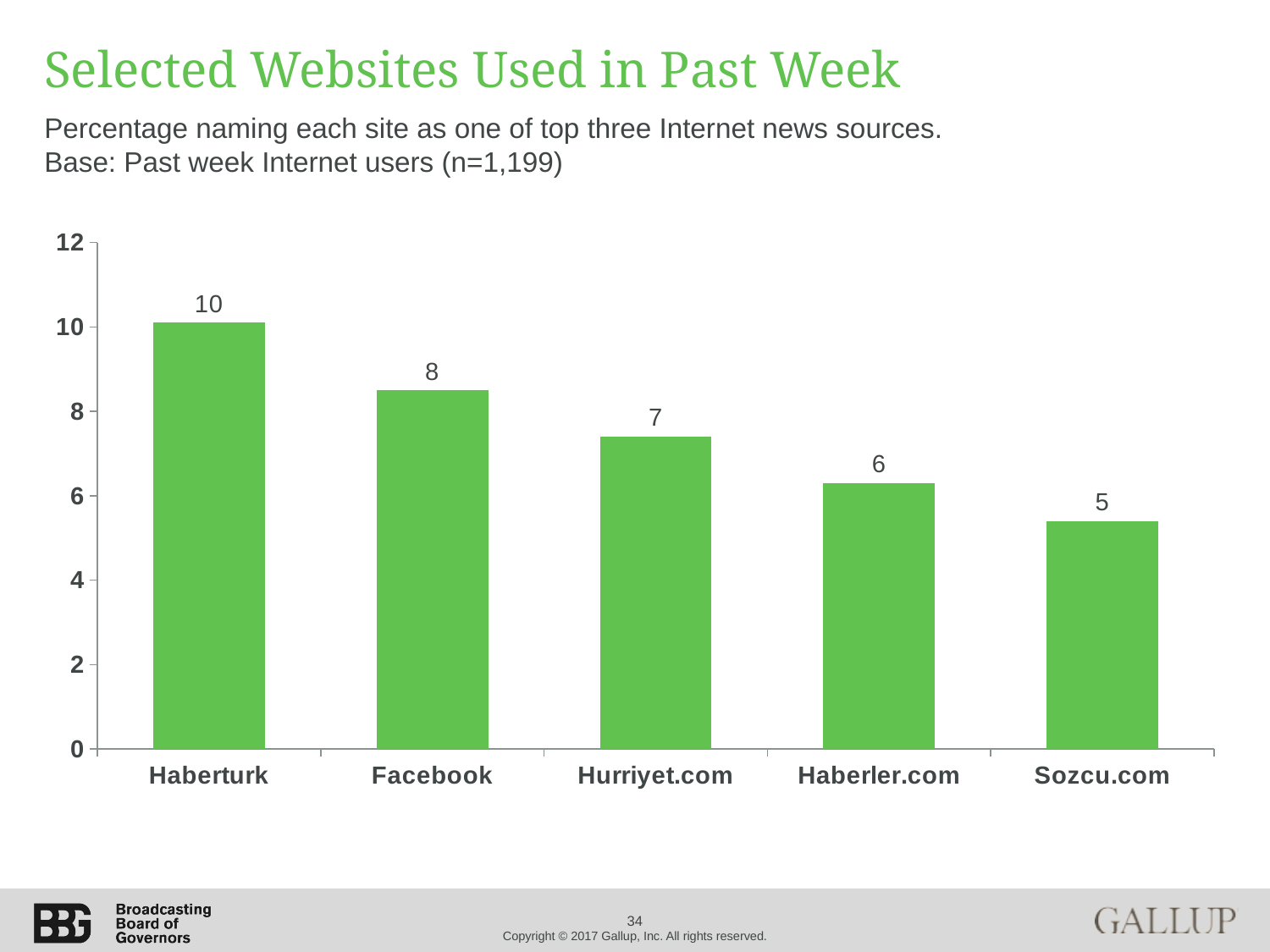
What is the value for Hurriyet.com? 7 Which is larger, the value for Facebook or the value for Hurriyet.com? Facebook Which website has the lowest value? Sozcu.com What is the value for Sozcu.com? 5 What kind of chart is shown on the slide? Bar chart Is the value for Haberler.com greater or less than 4? greater Do the values rise or fall from left to right across the chart? Fall How many websites are shown in the chart? 5 What is the difference between the values for Haberturk and Haberler.com? 4 What is the value for Haberturk? 10 Which website has the highest value? Haberturk What is the value for Facebook? 8